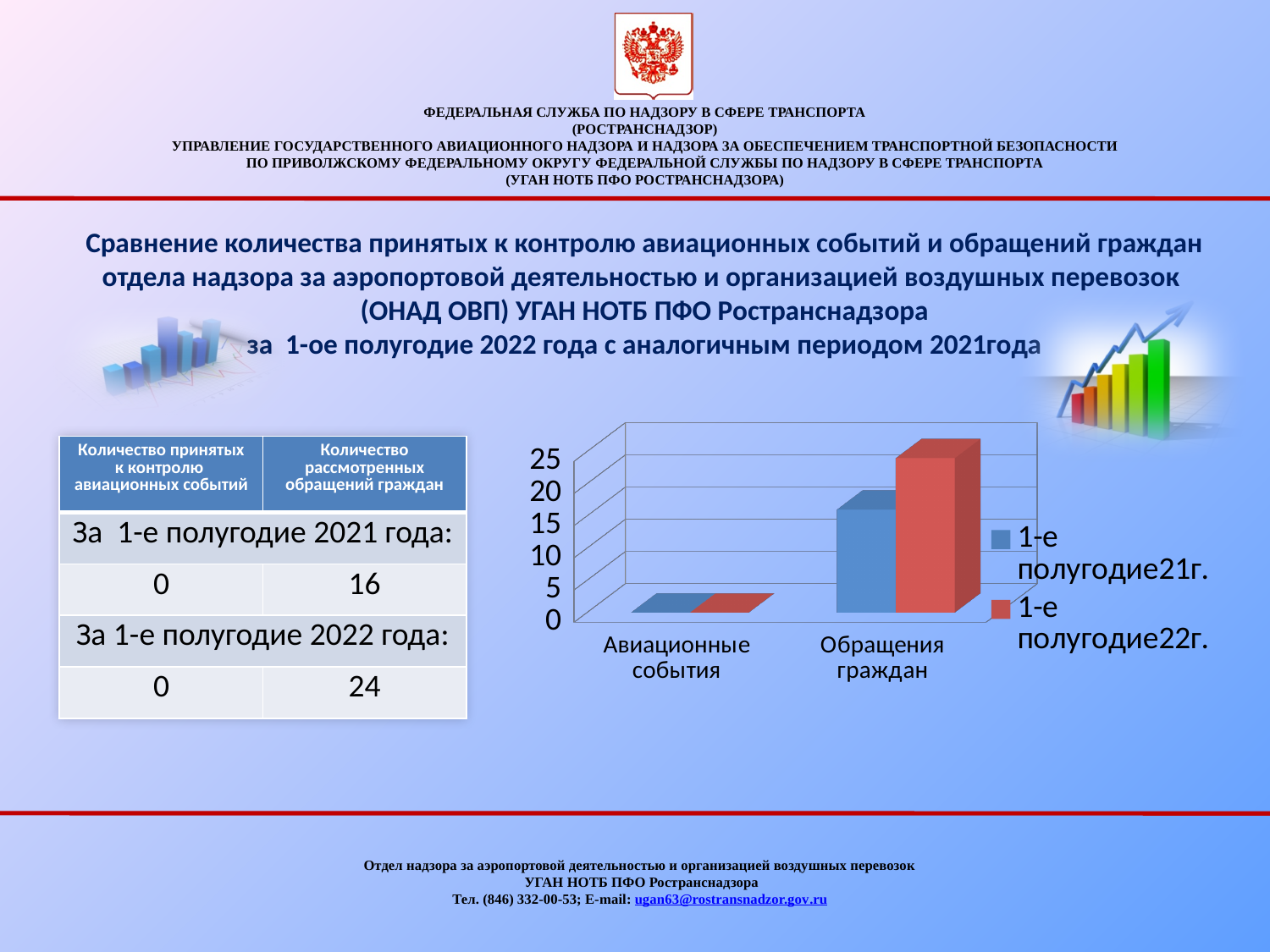
Is the value for Обращения граждан in the 1-е полугодие22г. series greater or less than 20? greater What is the value for Обращения граждан in the 1-е полугодие22г. series? 24 For Обращения граждан, which series has the larger value, 1-е полугодие21г. or 1-е полугодие22г.? 1-е полугодие22г. What is the difference between the 1-е полугодие22г. and 1-е полугодие21г. values for Обращения граждан? 8 Is the value for Обращения граждан in the 1-е полугодие21г. series greater or less than 20? less What kind of chart is shown on the slide? bar chart What is the value for Обращения граждан in the 1-е полугодие21г. series? 16 How many categories are shown on the x axis of the chart? 2 What is the value for Авиационные события in the 1-е полугодие21г. series? 0 Which category has the highest bar in the chart? Обращения граждан How many series does the chart legend list? 2 What colour represents the 1-е полугодие22г. series in the chart? red